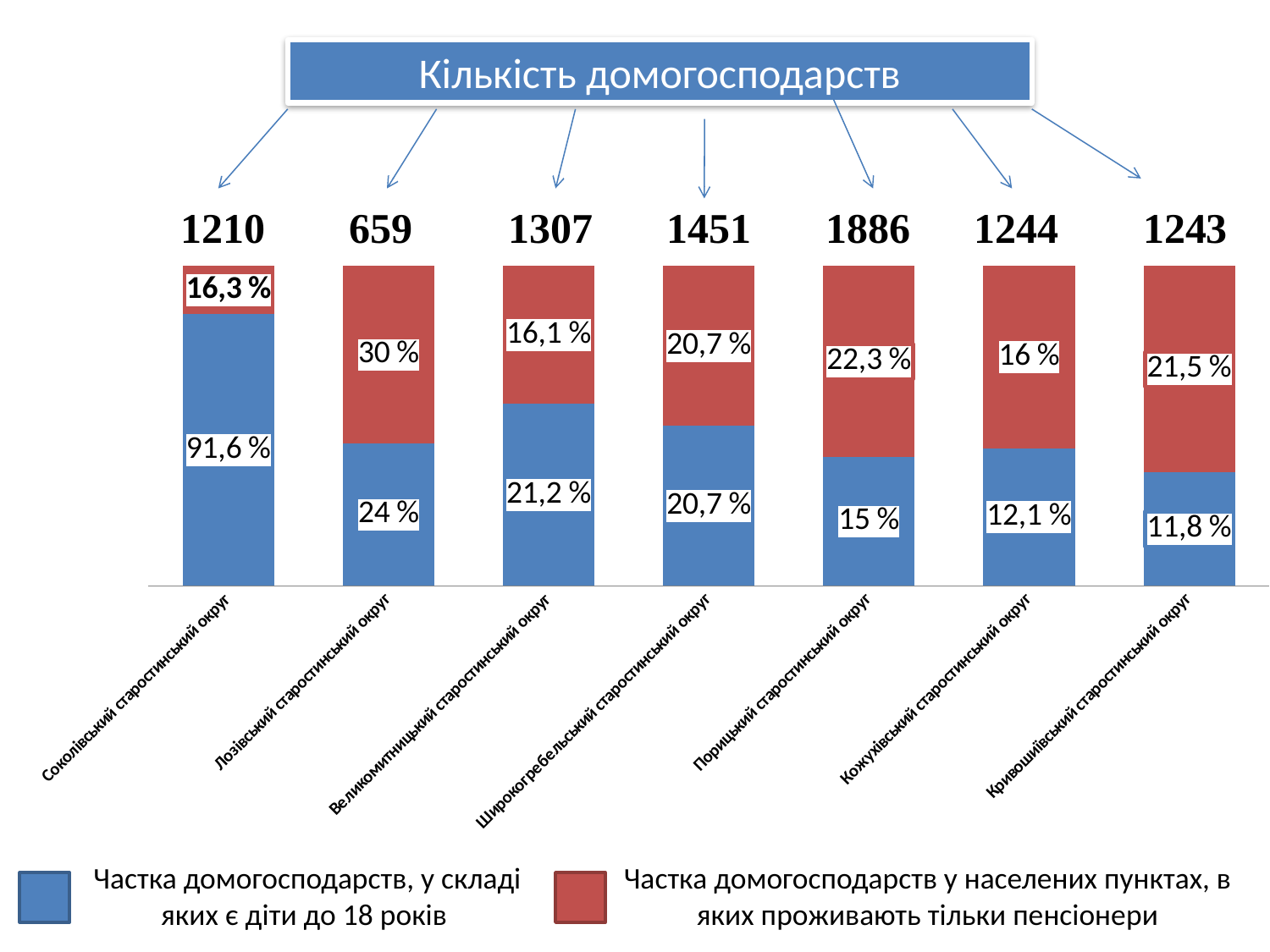
What percentage of households with children under 18 is shown for Кривошиївський старостинський округ? 11,8 % For Лозівський старостинський округ, what is the difference between the pensioner-only share and the share with children under 18? 6 % Which округ has the lowest number of households shown above the bars? Лозівський старостинський округ What share of households in settlements where only pensioners live is shown for Лозівський старостинський округ? 30 % What is the difference between the number of households in Порицький and Лозівський старостинський округ? 1227 Which округ has the highest share of households with children under 18 (blue segment)? Соколівський старостинський округ What percentage of households with children under 18 is shown for Соколівський старостинський округ? 91,6 % How many старостинські округи are shown on the chart? 7 What is the number of households (Кількість домогосподарств) shown above the bar for Порицький старостинський округ? 1886 Which округ has the highest number of households shown above the bars? Порицький старостинський округ How many series does the legend list? 2 Which округ has the highest share of households in settlements with only pensioners (red segment)? Лозівський старостинський округ